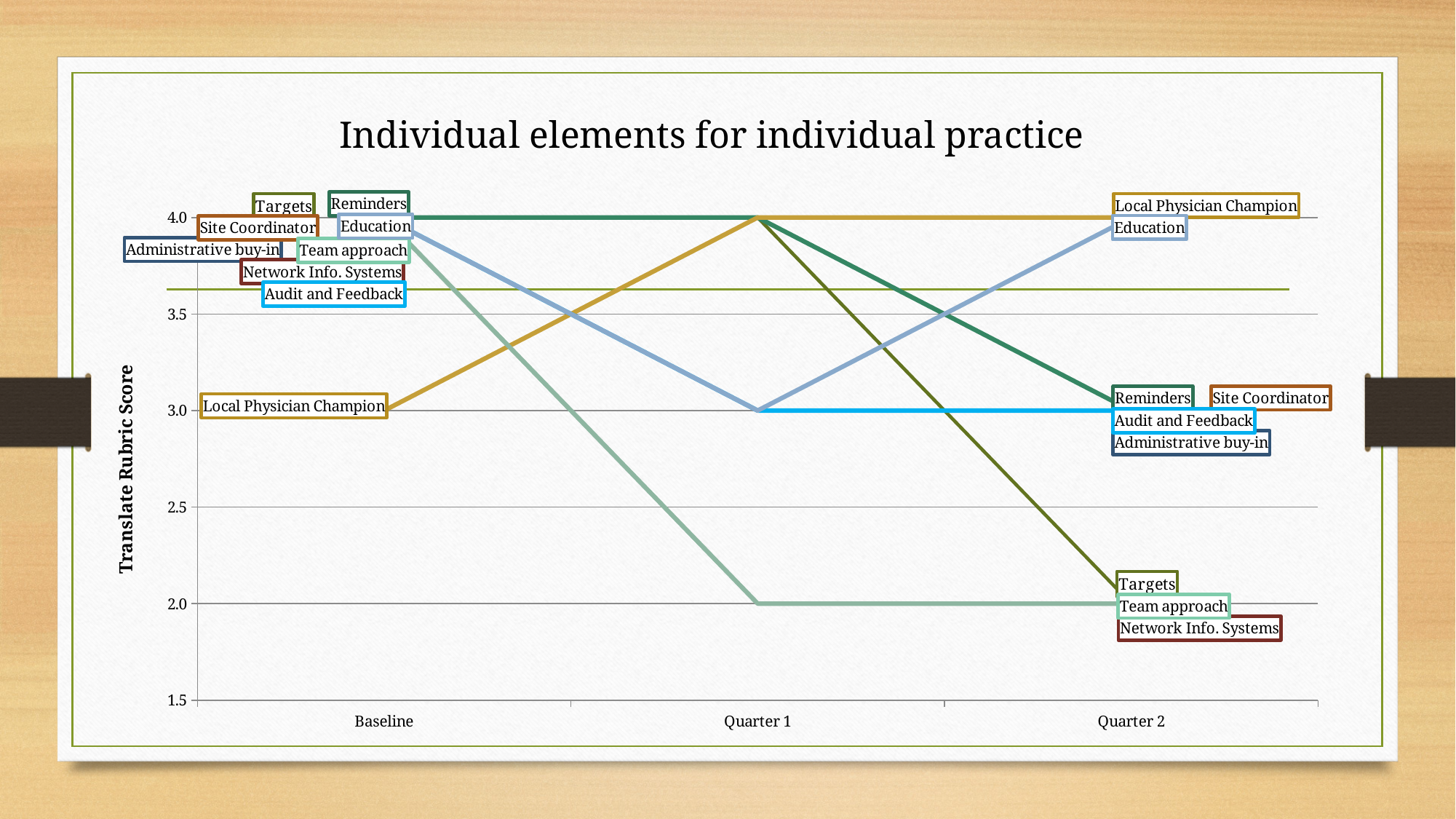
How many elements (series) are labeled at Quarter 2 on the chart? 9 What is the title of the chart? Individual elements for individual practice What is the score for Team approach at Quarter 1? 2.0 What kind of chart is shown on the slide? line chart What is the label on the vertical axis of the chart? Translate Rubric Score How many time points are shown on the x axis? 3 Which element has the lowest score at Quarter 1? Team approach and Network Info. Systems (tied at 2.0) What is the score for Local Physician Champion at Baseline? 3.0 What is the score for Targets at Quarter 2? 2.0 What is the score for Education at Quarter 1? 3.0 At Quarter 2, which has the higher score: Education or Team approach? Education Does the score for Local Physician Champion rise or fall from Baseline to Quarter 1? rise